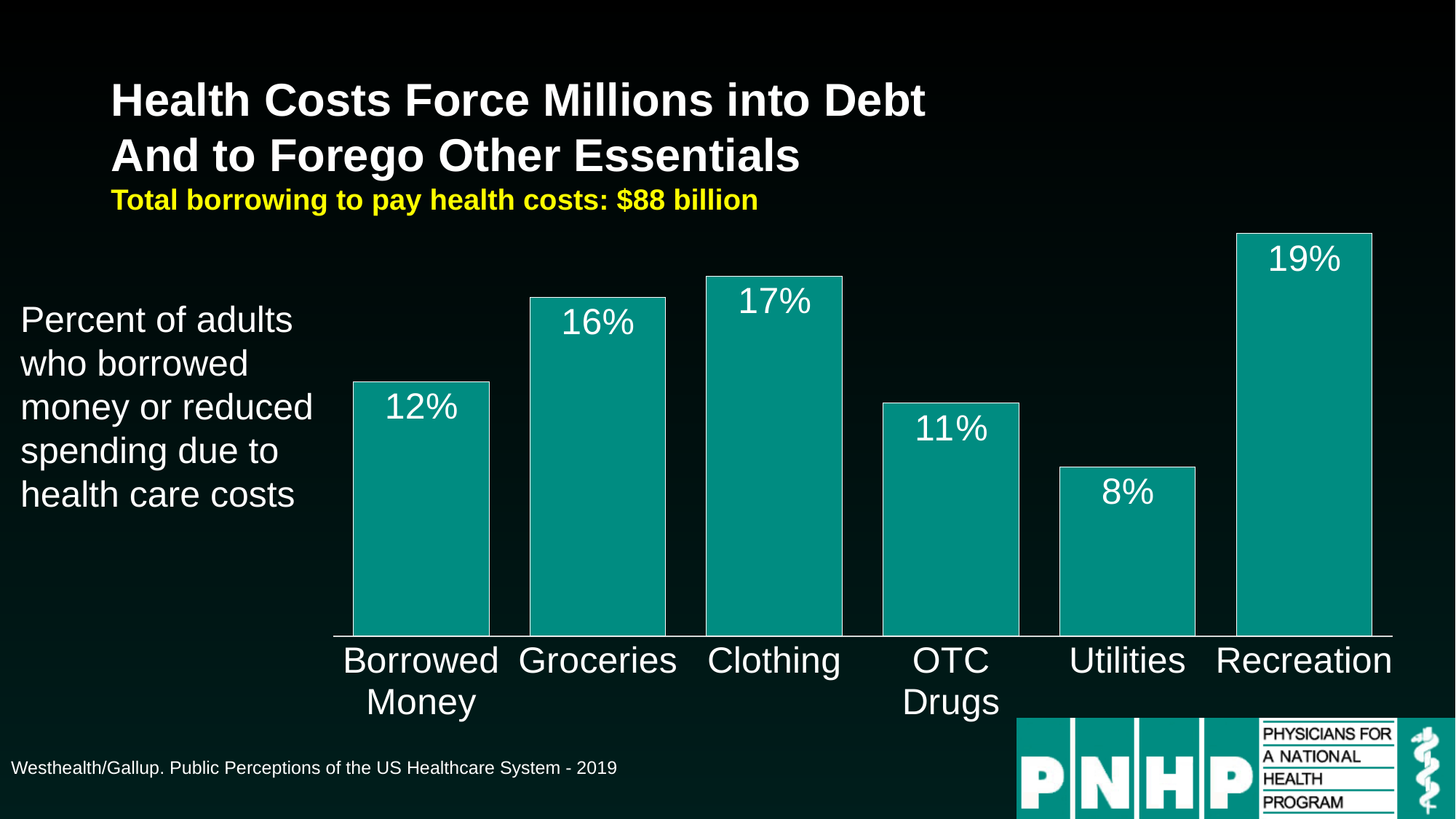
What total borrowing to pay health costs is stated on the slide? $88 billion How many categories are shown in the chart? 6 Which category has the highest value? Recreation Which category has the lowest value? Utilities Which is larger, the value for Clothing or the value for OTC Drugs? Clothing What is the value shown for OTC Drugs? 11% What is the value shown for Groceries? 16% What is the value shown for Utilities? 8% What is the difference between the values for Recreation and Utilities? 11% What percentage of adults borrowed money due to health care costs? 12% What is the difference between the values for Clothing and Groceries? 1% What kind of chart is shown on the slide? Bar chart